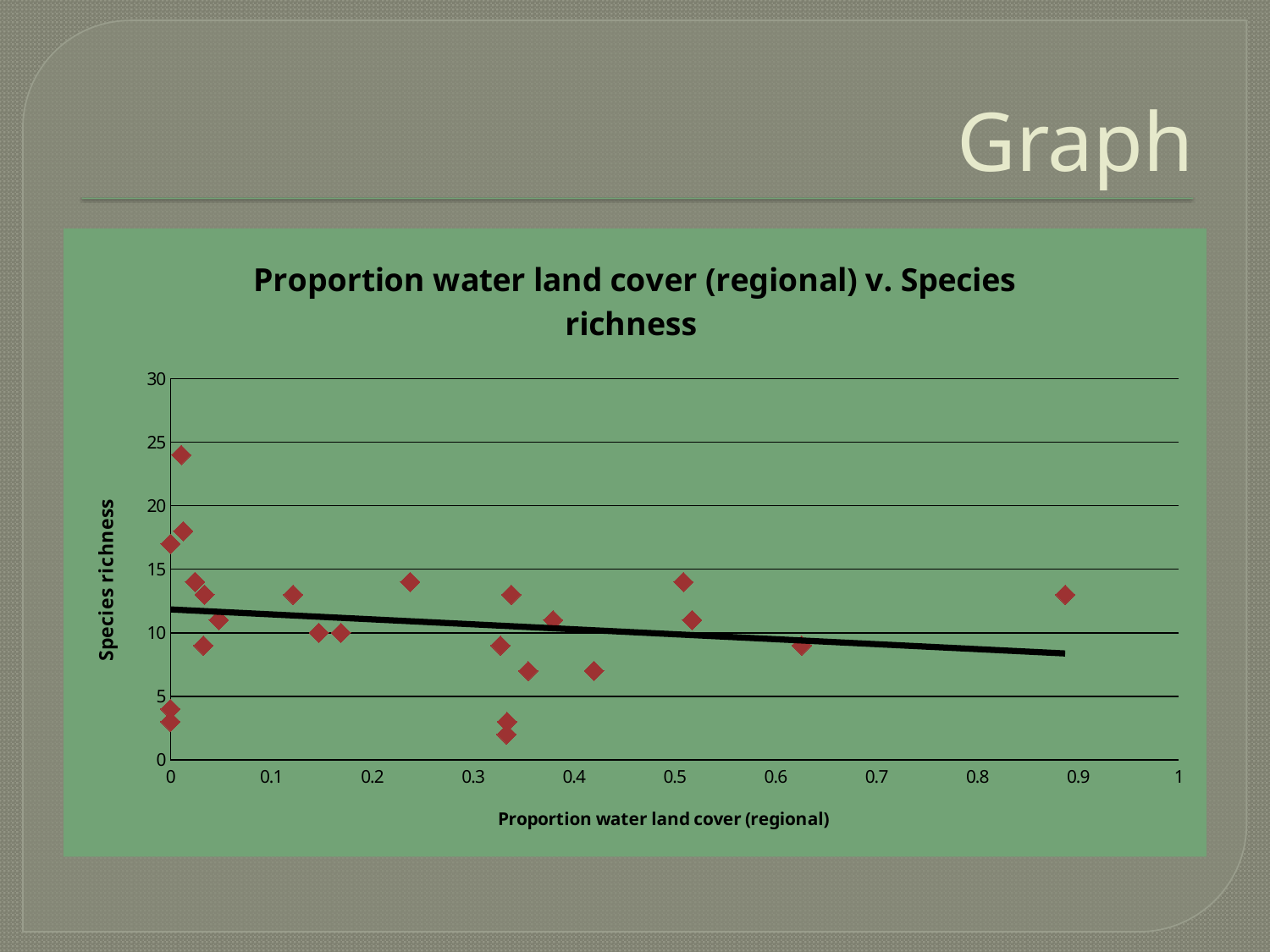
What is the title of the chart? Proportion water land cover (regional) v. Species richness What kind of chart is shown on the slide? Scatter chart Does the trend line rise or fall as the proportion of water land cover increases? Falls What is the label of the vertical axis? Species richness What is the maximum value shown on the vertical axis? 30 Is the species richness of the point at roughly 0.63 proportion water land cover greater or less than 10? less Near which x-axis value is the point with the highest species richness located? 0 Which has higher species richness: the point at about 0.24 proportion water land cover or the point at about 0.42? The point at about 0.24 Are the lowest points near 0.33 proportion water land cover greater or less than 5 in species richness? less Is the species richness of the highest point on the chart greater or less than 20? greater